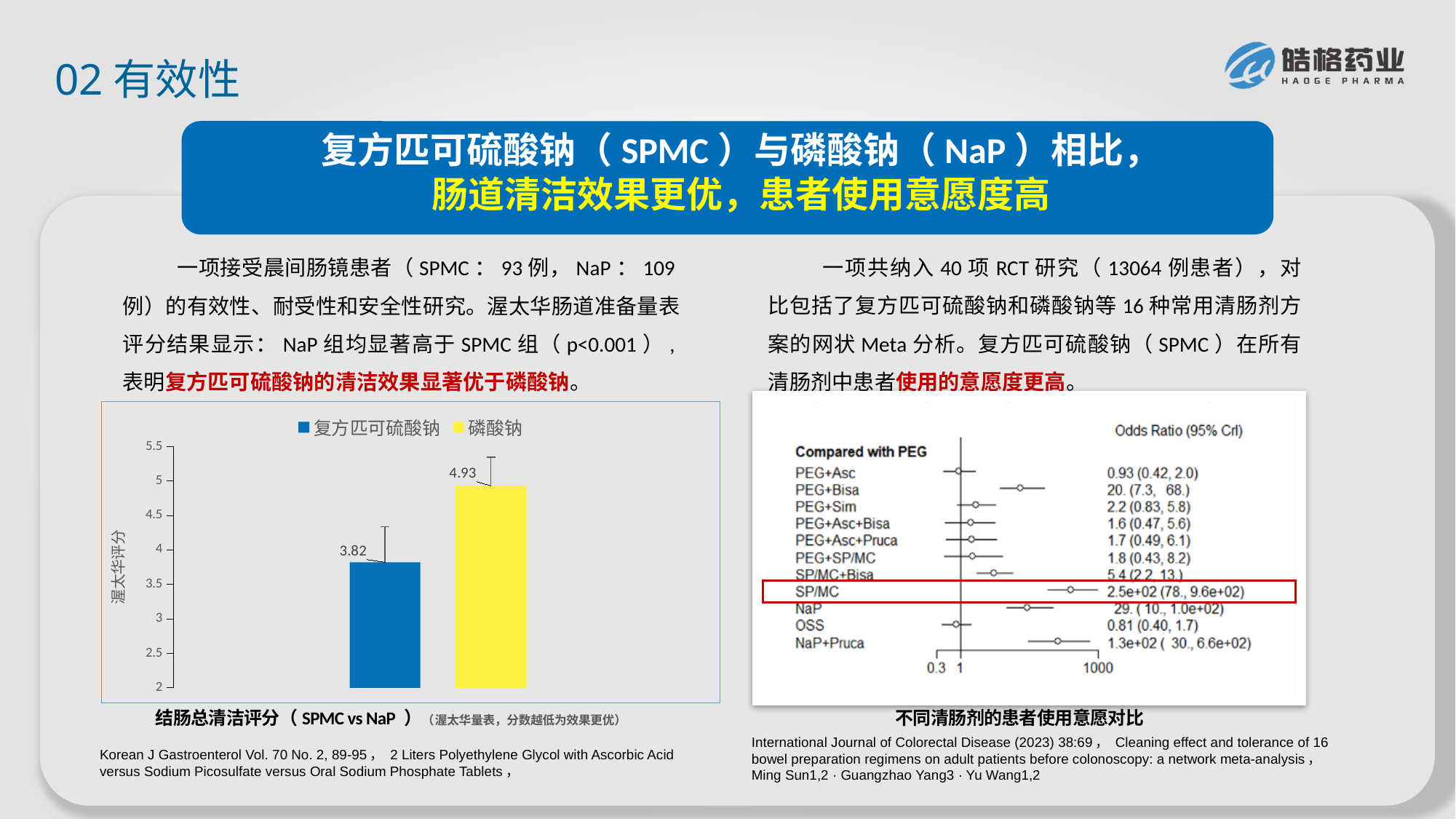
How many series does the legend of the bar chart on the left list? 2 In the bar chart on the left, what is the label on the vertical axis? 渥太华评分 In the bar chart on the left, is the value for 磷酸钠 greater or less than 4.5? greater In the bar chart on the left, what is the difference between the values for 磷酸钠 and 复方匹可硫酸钠? 1.11 In the bar chart on the left, which category has the lowest value? 复方匹可硫酸钠 How many bars are plotted in the bar chart on the left? 2 In the bar chart on the left, what is the value for 复方匹可硫酸钠? 3.82 In the bar chart on the left, which category has the highest value? 磷酸钠 In the bar chart on the left, is the value for 复方匹可硫酸钠 greater or less than 4? less In the bar chart on the left, what is the value for 磷酸钠? 4.93 In the forest plot on the right (不同清肠剂的患者使用意愿对比), what odds ratio (95% CrI) is printed for SP/MC? 2.5e+02 (78., 9.6e+02) What kind of chart is the chart on the left of the slide? bar chart